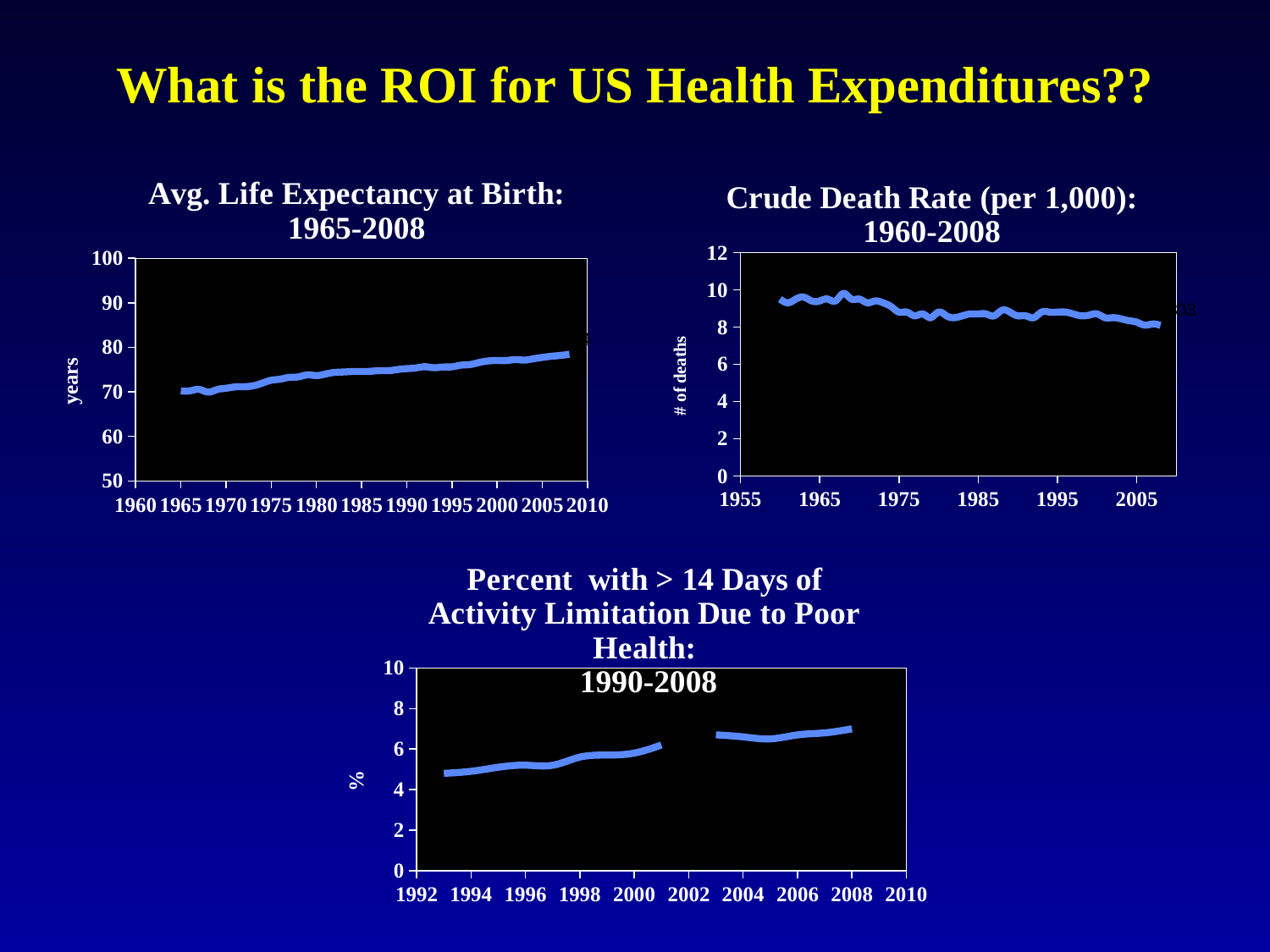
In the 'Percent with > 14 Days of Activity Limitation Due to Poor Health: 1990-2008' chart, do the values rise or fall from the early 1990s to 2008? rise In the 'Avg. Life Expectancy at Birth: 1965-2008' chart, is the value for 1965 greater or less than 80? less In the 'Crude Death Rate (per 1,000): 1960-2008' chart, do the values rise or fall over time? fall In the 'Crude Death Rate (per 1,000): 1960-2008' chart, is the value for 1965 greater or less than 8? greater In the 'Percent with > 14 Days of Activity Limitation Due to Poor Health: 1990-2008' chart, is the value for 2008 greater or less than 6? greater What kind of chart is the 'Avg. Life Expectancy at Birth: 1965-2008' chart? line chart What is the y-axis label of the 'Crude Death Rate (per 1,000): 1960-2008' chart? # of deaths In the 'Avg. Life Expectancy at Birth: 1965-2008' chart, do the values rise or fall from 1965 to 2008? rise How many charts are shown on the slide? 3